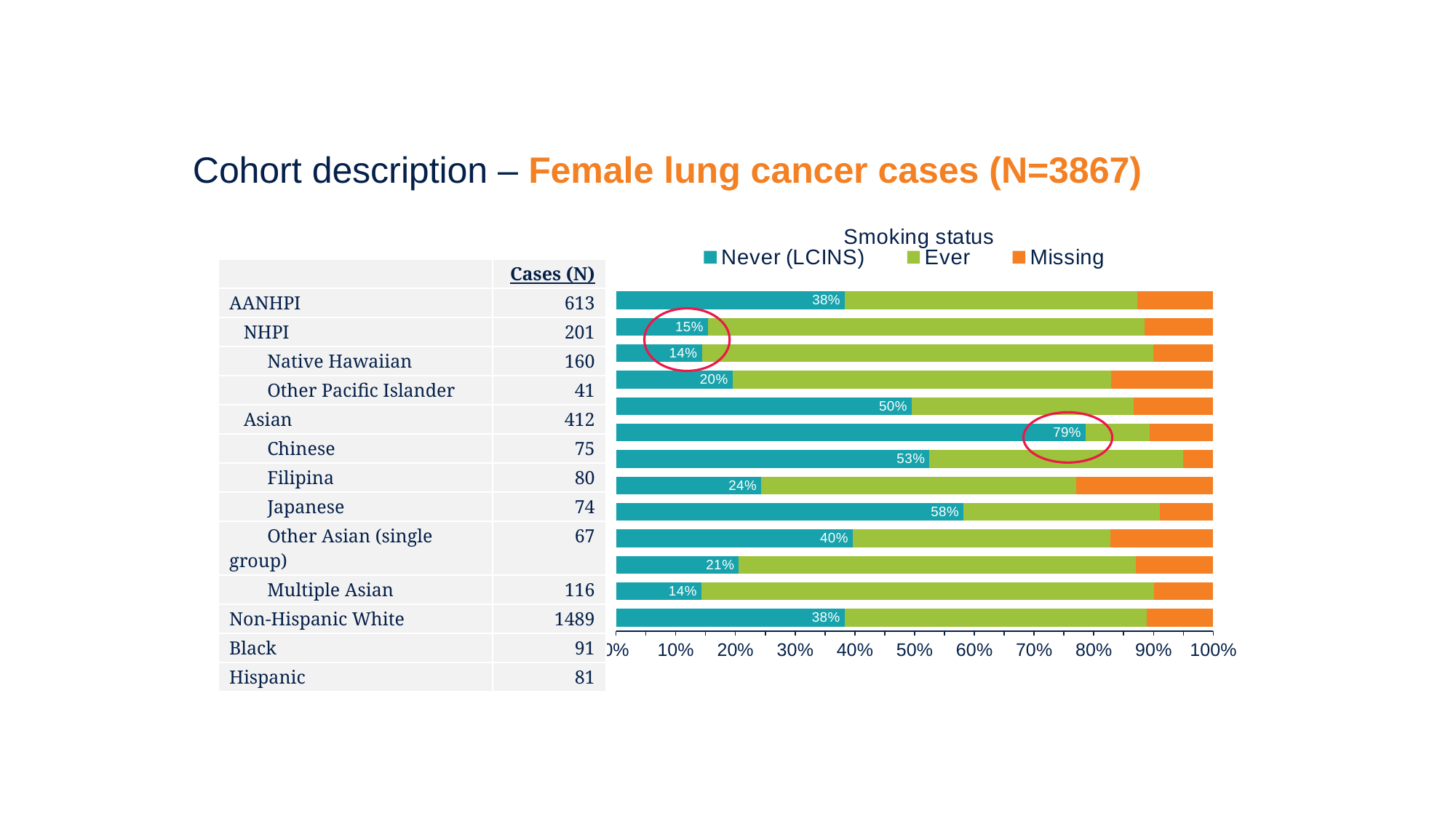
Is the Never (LCINS) value on the ninth bar from the top greater or less than 50%? greater What is the Never (LCINS) percentage shown on the top bar of the chart? 38% What kind of chart is shown on the slide? stacked bar chart What is the highest Never (LCINS) percentage labelled on any bar in the chart? 79% What is the difference between the highest labelled Never (LCINS) percentage (79%) and the lowest (14%)? 65% What is the Never (LCINS) percentage labelled on the sixth bar from the top? 79% What are the three series named in the chart legend? Never (LCINS), Ever, Missing What is the lowest Never (LCINS) percentage labelled on any bar in the chart? 14% Which is larger: the Never (LCINS) percentage on the fifth bar from the top (50%) or on the seventh bar from the top (53%)? 53% How many series does the chart legend list? 3 How many bars are plotted in the chart? 13 What is the title shown above the chart legend? Smoking status